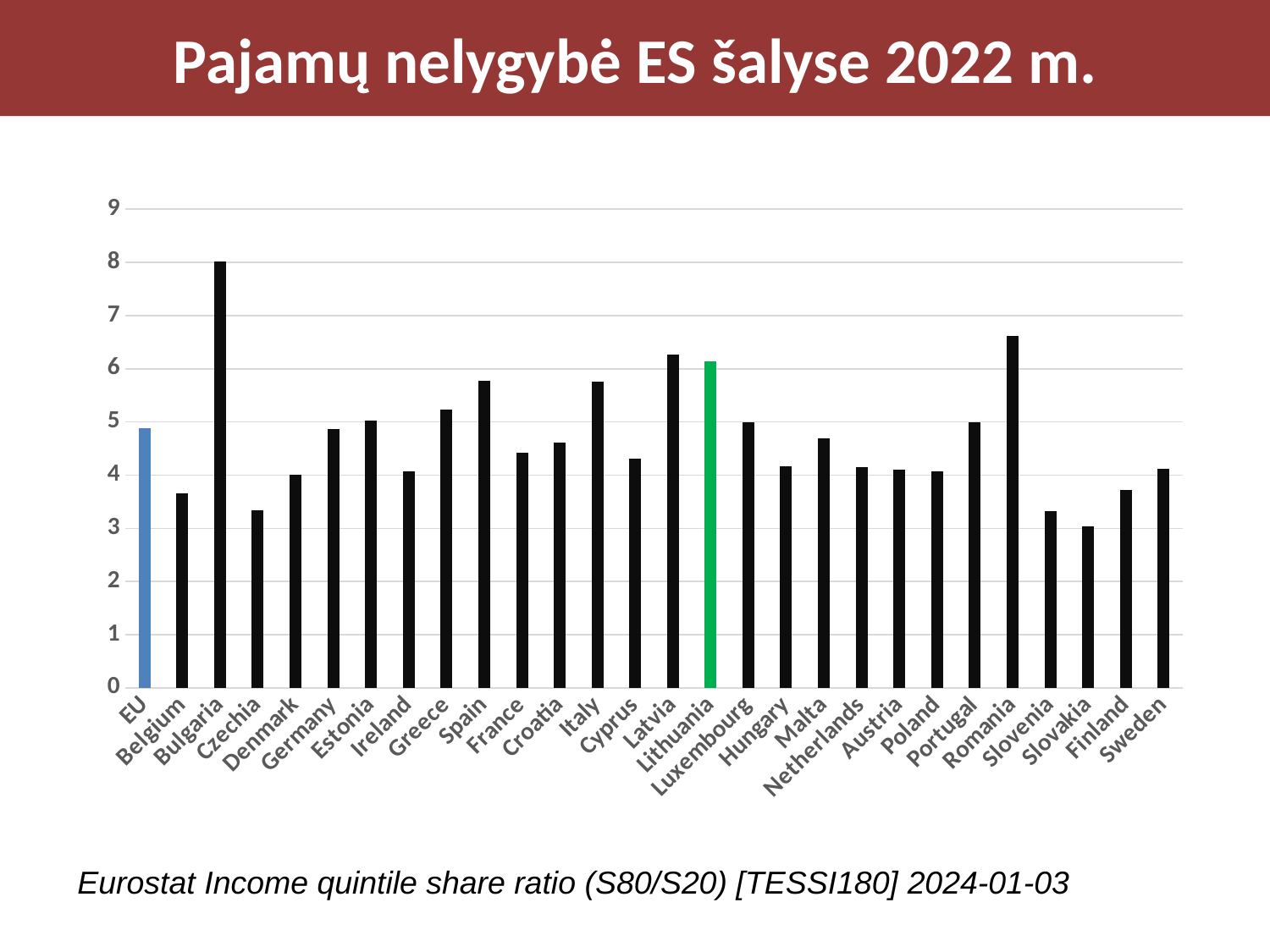
What is the title of the slide? Pajamų nelygybė ES šalyse 2022 m. What colour is the bar for Lithuania? green Is the value for Bulgaria greater or less than 7? greater Which is larger, the value for Bulgaria or the value for Romania? Bulgaria Which is larger, the value for Lithuania or the value for EU? Lithuania Is the value for Lithuania greater or less than 6? greater What kind of chart is shown on the slide? bar chart Is the value for Slovakia greater or less than 4? less How many categories (bars) are shown on the x axis? 28 Which category has the lowest value? Slovakia Which category has the highest value? Bulgaria